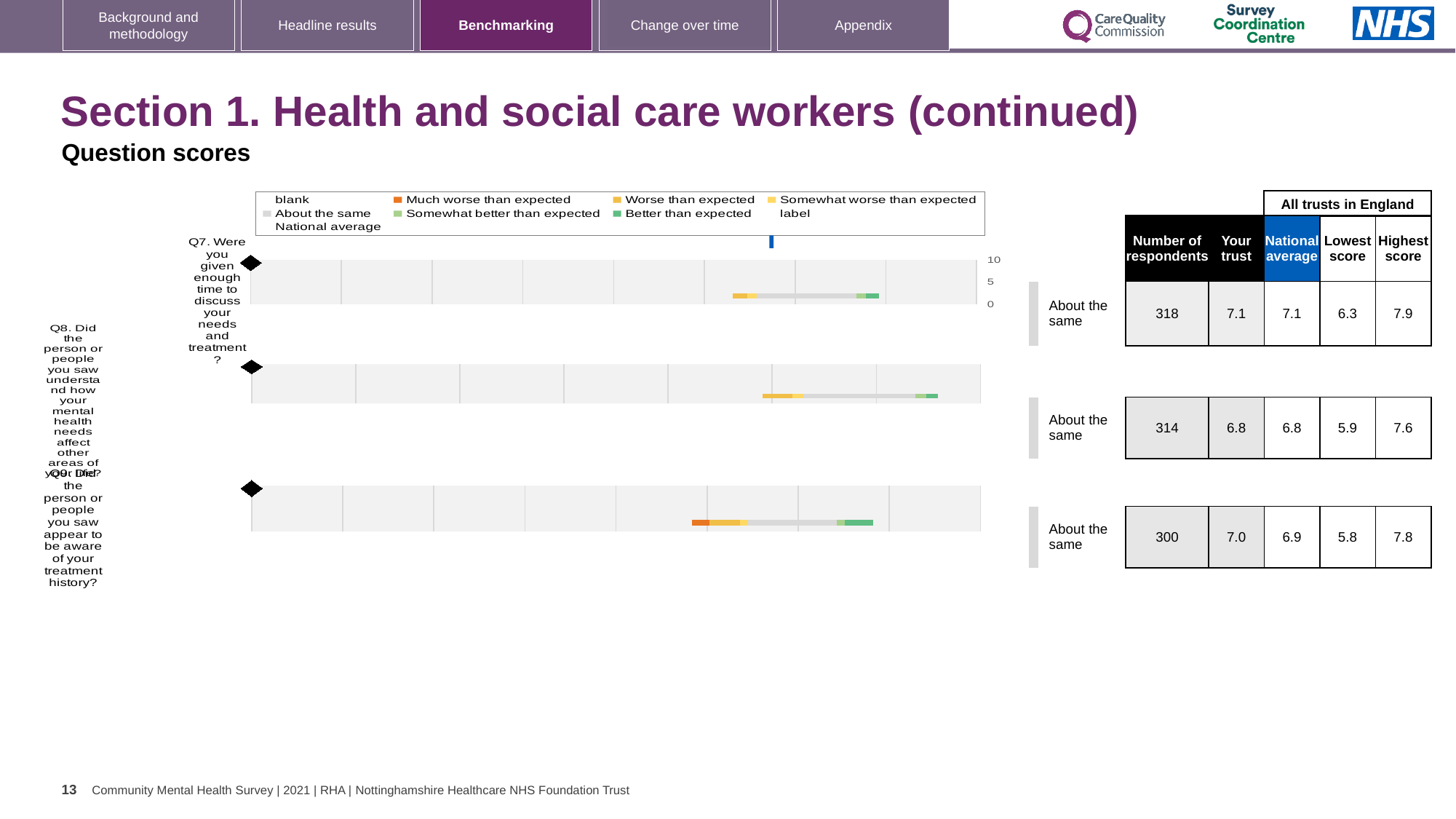
For Q8 (understanding how mental health needs affect other areas of life), what is the national average score? 6.8 For Q9, what is the lowest score among all trusts in England? 5.8 How many questions (Q7, Q8, Q9) are plotted on this slide? 3 For Q7, what is the 'Your trust' score? 7.1 For Q9 (awareness of treatment history), what is the highest score among all trusts in England? 7.8 For Q9, is the 'Your trust' score or the national average score higher? Your trust Which question has the largest number of respondents? Q7 For Q7, what is the difference between the highest score and the lowest score across all trusts in England? 1.6 What benchmark category is shown for Q8? About the same Which question has the lowest 'Your trust' score? Q8 For Q7 (time to discuss needs and treatment), what is the number of respondents? 318 What kind of chart is used to show the question scores on this slide? bar chart